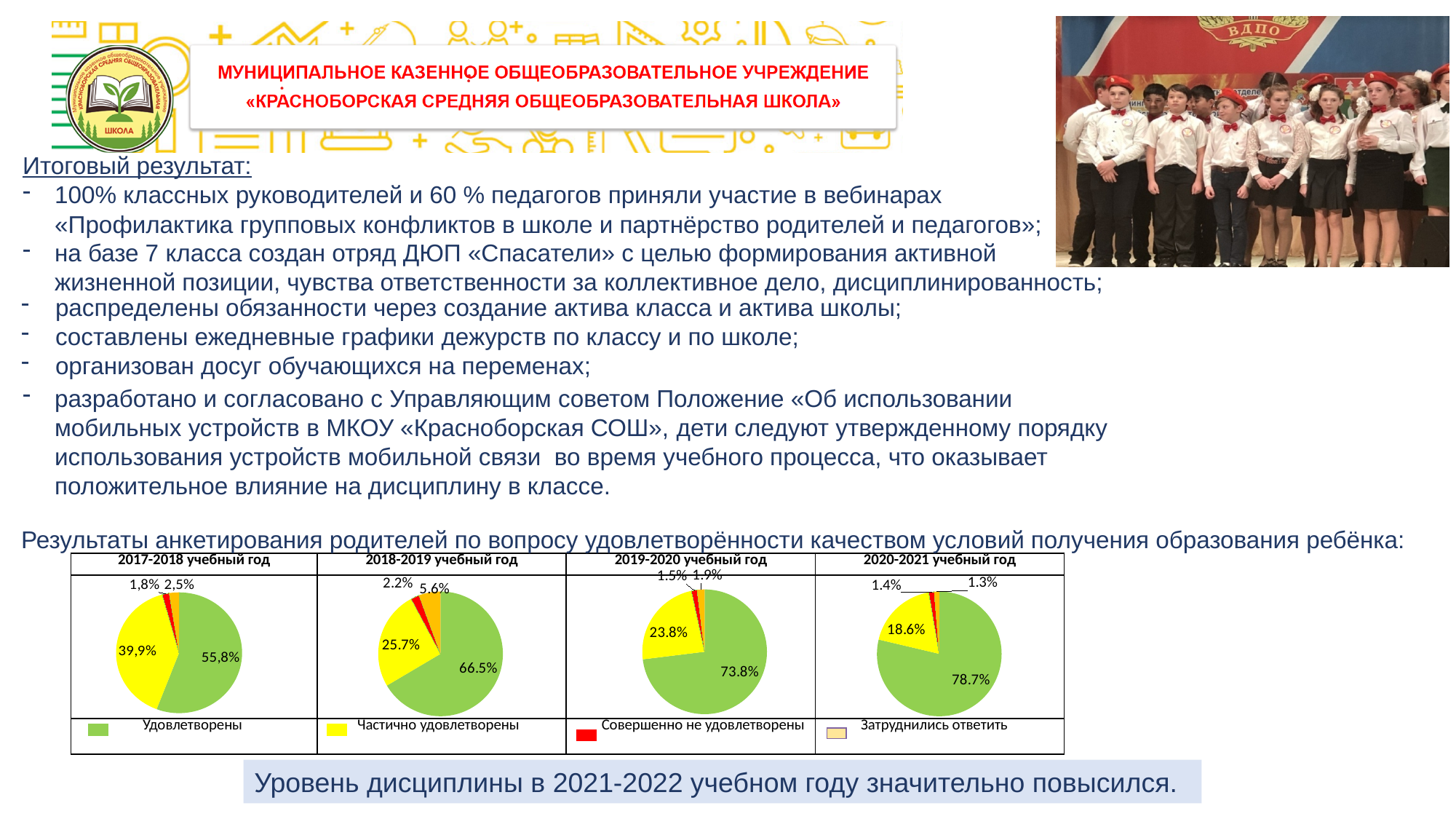
In the 2017-2018 учебный год pie chart, what share is labelled for the Частично удовлетворены (yellow) slice? 39,9% How many categories does the legend below the pie charts list? 4 In the 2018-2019 учебный год pie chart, what share is labelled for the Удовлетворены (green) slice? 66.5% Does the share of Удовлетворены (green) rise or fall from the 2017-2018 chart to the 2020-2021 chart? Rise What is the difference between the Удовлетворены share in the 2020-2021 chart (78.7%) and in the 2019-2020 chart (73.8%)? 4.9% How many pie charts are shown for the parent survey results? 4 What type of chart is used to show the parent survey results for each school year? Pie chart In the 2018-2019 учебный год pie chart, what share is labelled for the Частично удовлетворены (yellow) slice? 25.7% In the 2020-2021 учебный год pie chart, which category has the largest slice? Удовлетворены In the 2019-2020 учебный год pie chart, what share is labelled for the Удовлетворены (green) slice? 73.8% In the 2020-2021 учебный год pie chart, what share is labelled for the Частично удовлетворены (yellow) slice? 18.6% In the 2017-2018 учебный год pie chart, what share is labelled for the Удовлетворены (green) slice? 55,8%